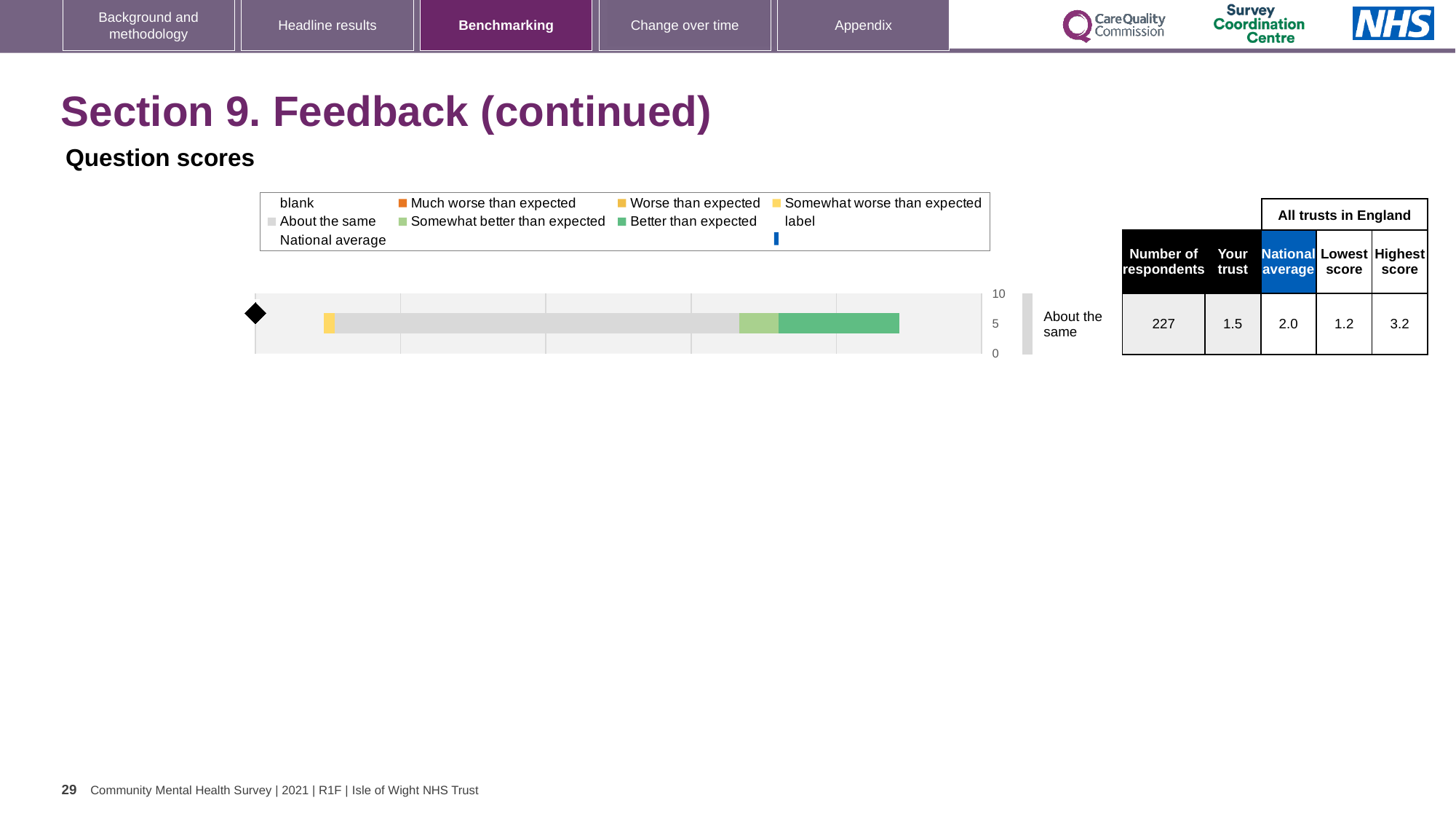
In the table beside the chart, what is the Highest score among all trusts in England for 'About the same'? 3.2 In the table beside the chart, which is larger for 'About the same': the Your trust score or the National average? National average How many bars are plotted in the chart? 1 In the table beside the chart, what is the difference between the Highest score and the Lowest score for 'About the same'? 2.0 In the table beside the chart, what is the 'Your trust' score for the 'About the same' row? 1.5 What kind of chart is shown on the slide? Bar chart How many entries does the chart legend list? 9 In the table beside the chart, what is the National average for the 'About the same' row? 2.0 In the table beside the chart, what is the number of respondents for the 'About the same' row? 227 Which colour represents 'Better than expected' in the chart legend? Green What is the category label shown next to the bar in the chart? About the same What is the highest value shown on the chart's axis? 10